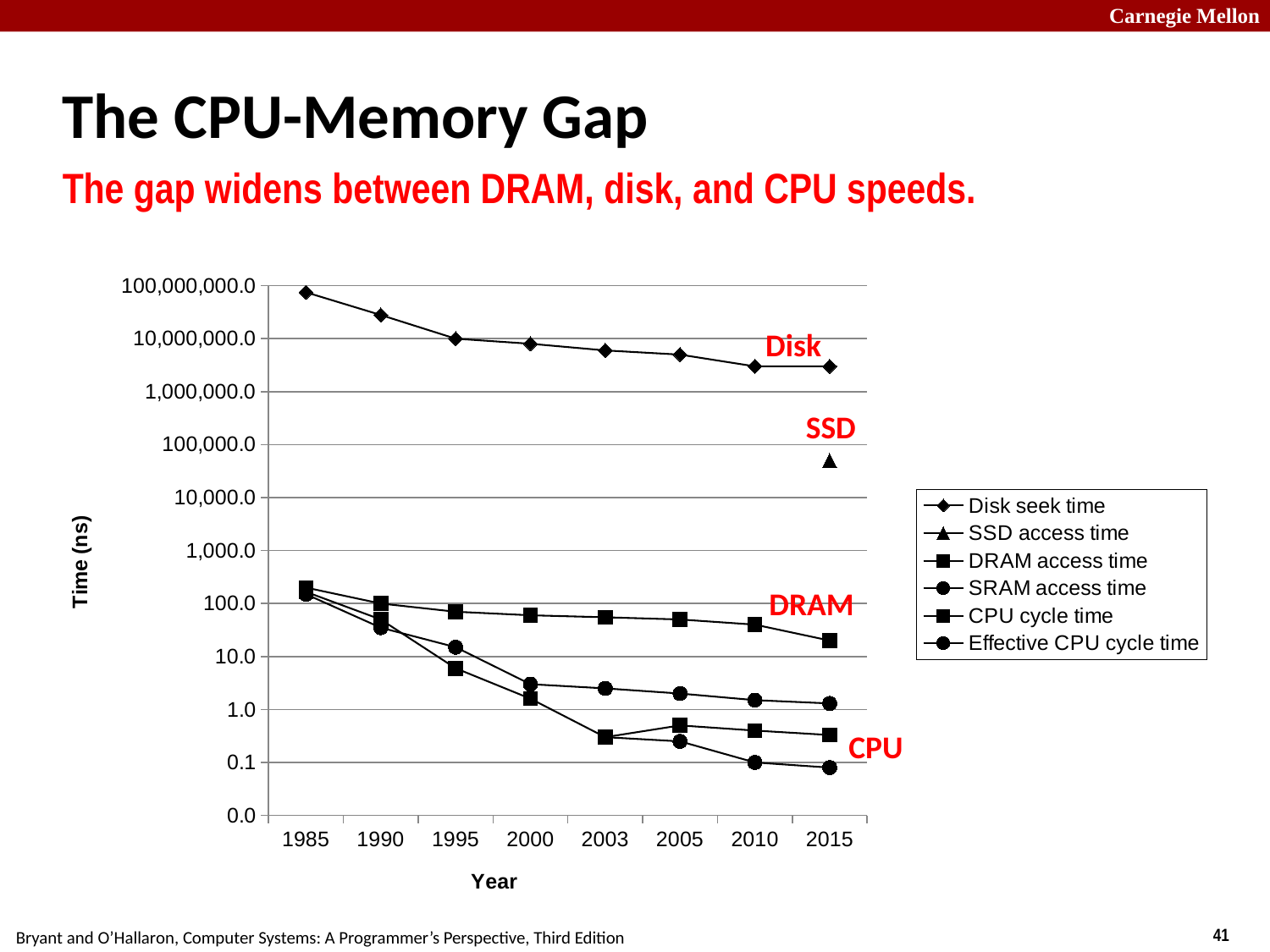
How many years are plotted along the x axis? 8 Which series has the lowest value in 2015? Effective CPU cycle time How many series does the legend list? 6 Does the Disk seek time rise or fall from 1985 to 2015? fall Is the DRAM access time in 2015 greater or less than 10.0? greater What is the label on the y axis? Time (ns) Which series has the highest value in 2015? Disk seek time Which is larger in 2015, the DRAM access time or the SRAM access time? DRAM access time Is the SSD access time in 2015 greater or less than 100,000.0? less Is the Disk seek time in 1985 greater or less than 10,000,000.0? greater What kind of chart is shown on the slide? line chart